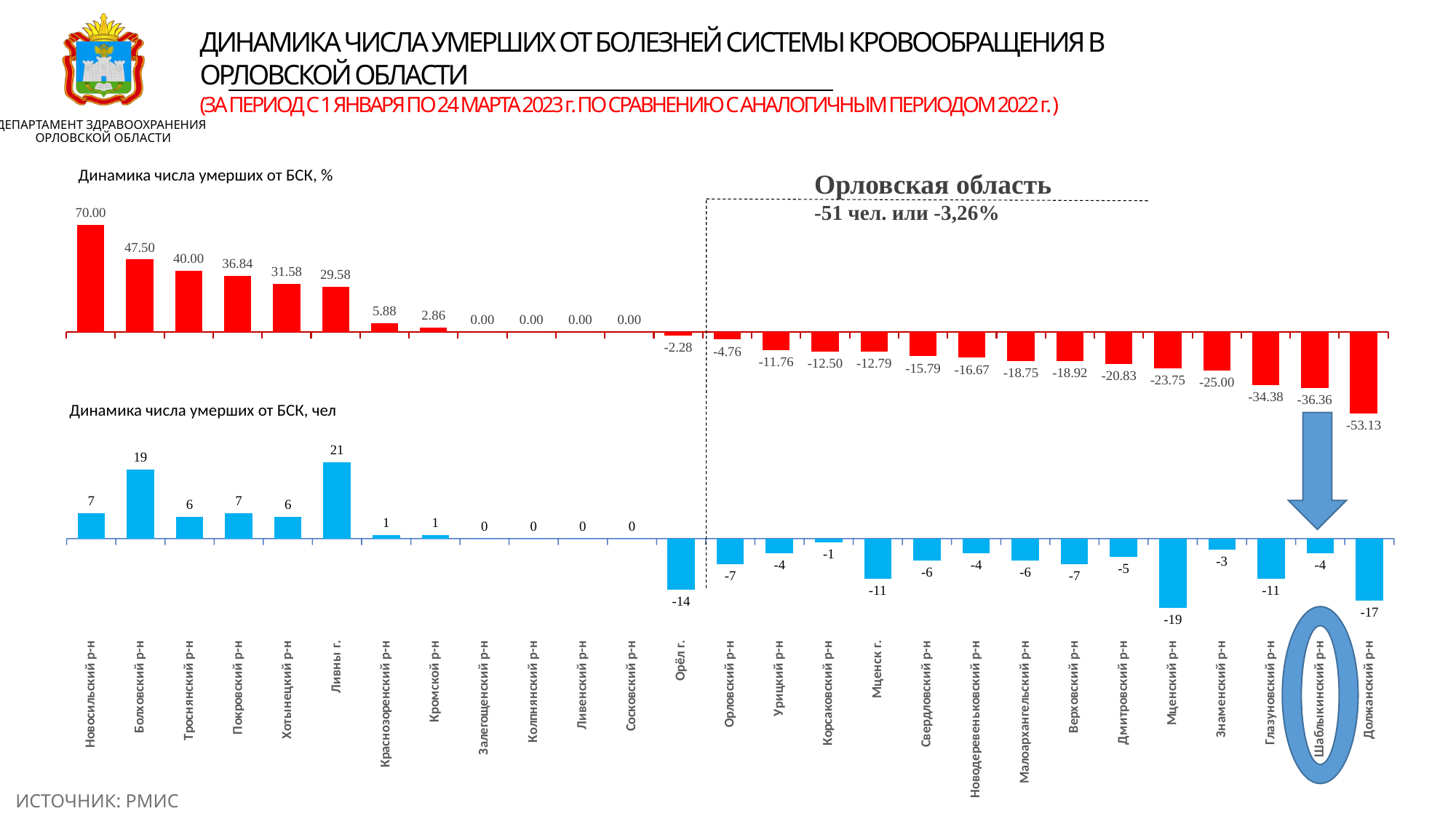
What is the title of the bottom chart on the slide? Динамика числа умерших от БСК, чел In the bottom chart (Динамика числа умерших от БСК, чел), which category has the highest value? Ливны г. In the top chart (Динамика числа умерших от БСК, %), what is the value for Новосильский р-н? 70.00 In the top chart (Динамика числа умерших от БСК, %), which is larger: the value for Троснянский р-н or the value for Хотынецкий р-н? Троснянский р-н In the top chart (Динамика числа умерших от БСК, %), what is the value for Должанский р-н? -53.13 What type of chart is the top chart (Динамика числа умерших от БСК, %)? Bar chart In the bottom chart (Динамика числа умерших от БСК, чел), what is the value for Мценский р-н? -19 In the bottom chart (Динамика числа умерших от БСК, чел), what is the difference between the values for Болховский р-н and Новосильский р-н? 12 In the bottom chart (Динамика числа умерших от БСК, чел), what is the value for Ливны г.? 21 How many categories are shown on the x axis of the bottom chart (Динамика числа умерших от БСК, чел)? 27 In the top chart (Динамика числа умерших от БСК, %), which category has the lowest value? Должанский р-н In the top chart (Динамика числа умерших от БСК, %), which category has the highest value? Новосильский р-н